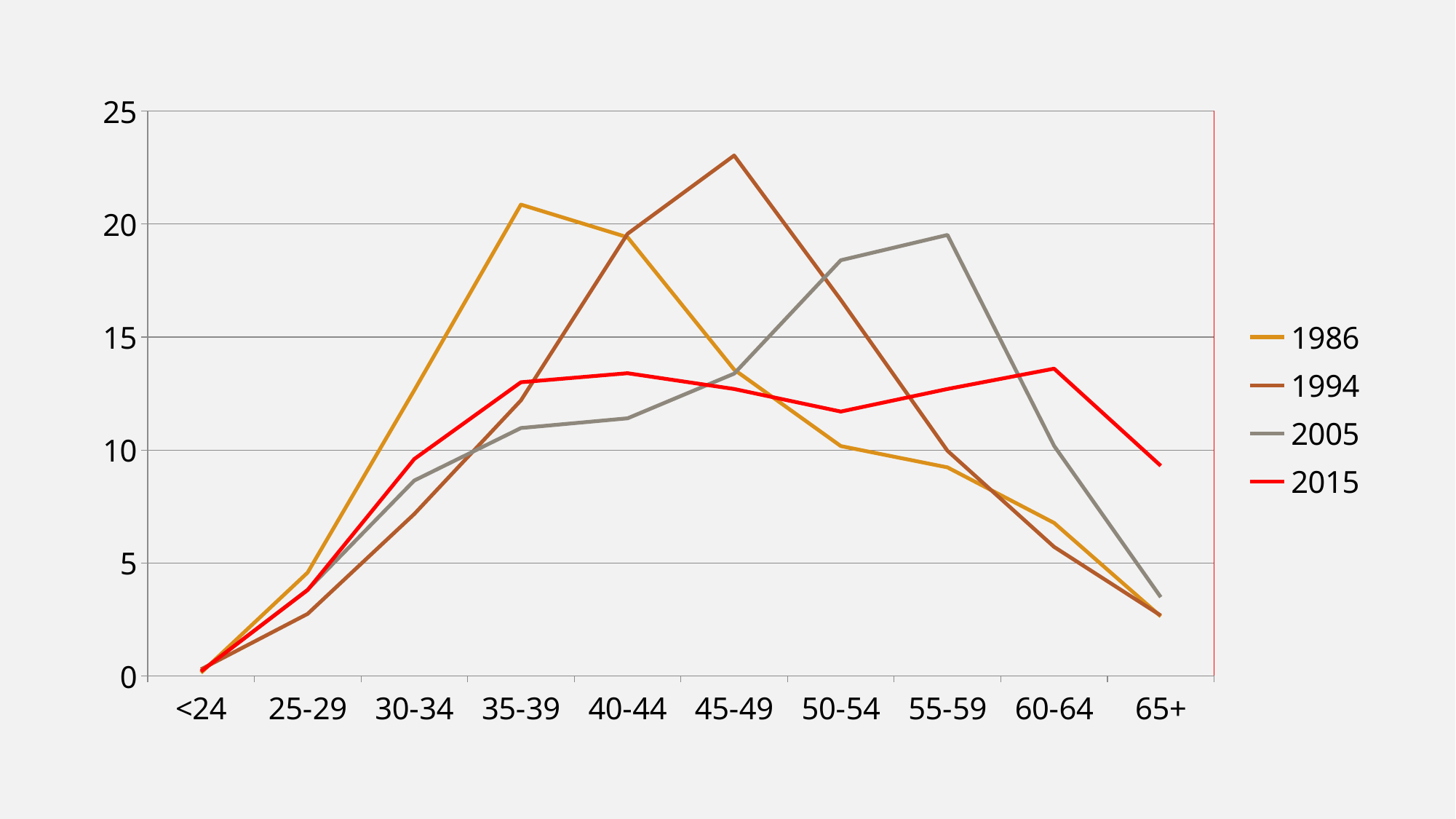
For the 1986 series, which age group has the highest value? 35-39 Does the 1986 series rise or fall from 35-39 to 65+? fall How many series does the legend list? 4 Is the value for 1994 at 45-49 greater or less than 20? greater Is the value for 2005 at 55-59 greater or less than 15? greater For the 1994 series, which age group has the highest value? 45-49 What kind of chart is shown on the slide? line chart At 45-49, which series has the larger value, 1994 or 2015? 1994 Is the value for 2015 at 65+ greater or less than 10? less For the 2015 series, which age group has the lowest value? <24 For the 2005 series, which age group has the highest value? 55-59 How many age-group categories are shown on the x axis? 10